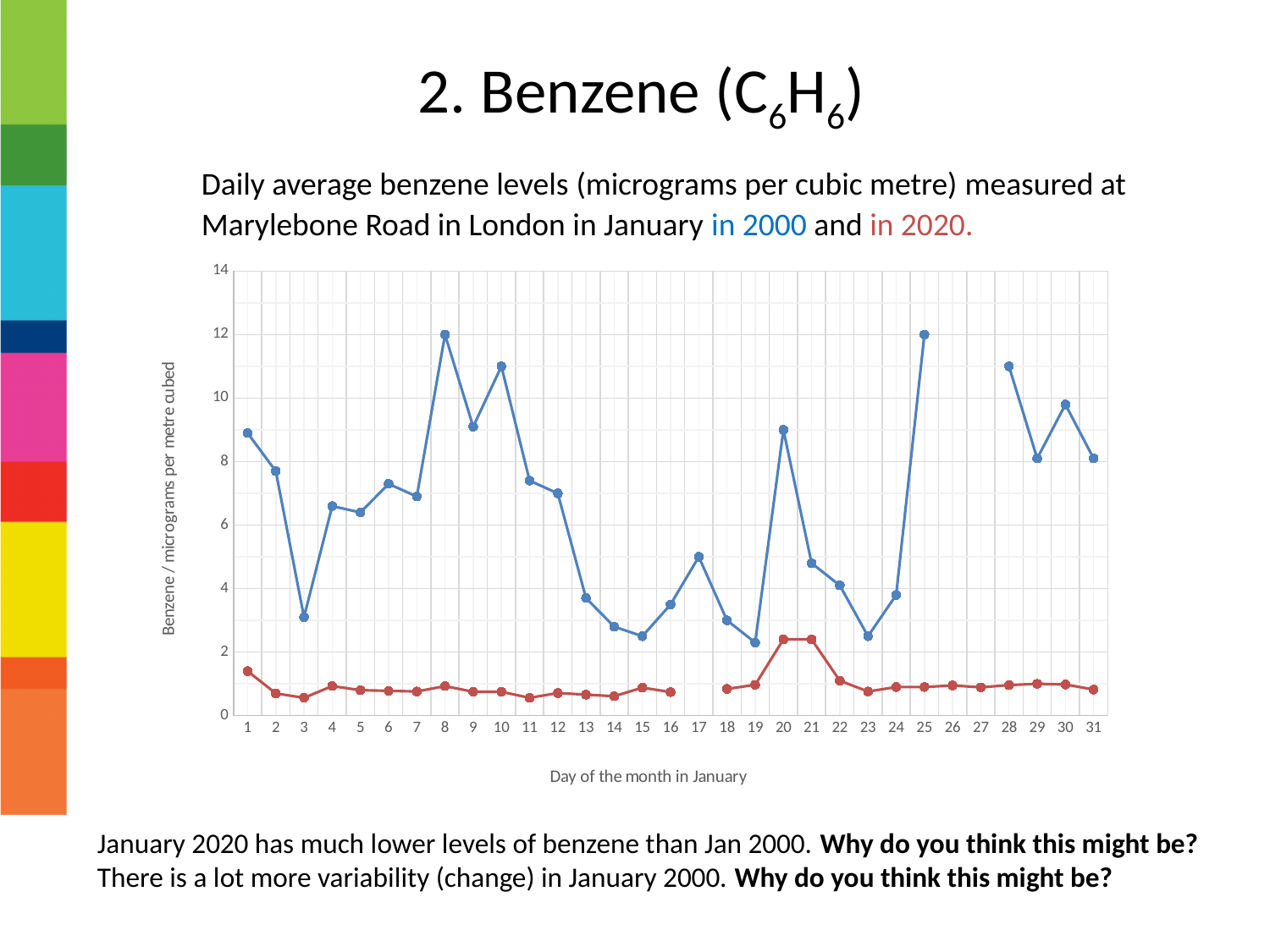
Is the benzene level for day 3 in 2020 greater or less than 2? less Is the benzene level for day 20 in 2000 greater or less than 8? greater How many days are labelled along the x axis of the chart? 31 What kind of chart is shown on the slide? line chart What is the benzene level for day 8 in 2000? 12 What is the title of the x axis of the chart? Day of the month in January How many data series (lines) are plotted on the chart? 2 In 2000, which day has the higher benzene level, day 3 or day 10? day 10 Does the 2000 benzene level rise or fall from day 1 to day 3? fall Is the benzene level for day 3 in 2000 greater or less than 4? less Which year has the higher benzene level on day 8, 2000 or 2020? 2000